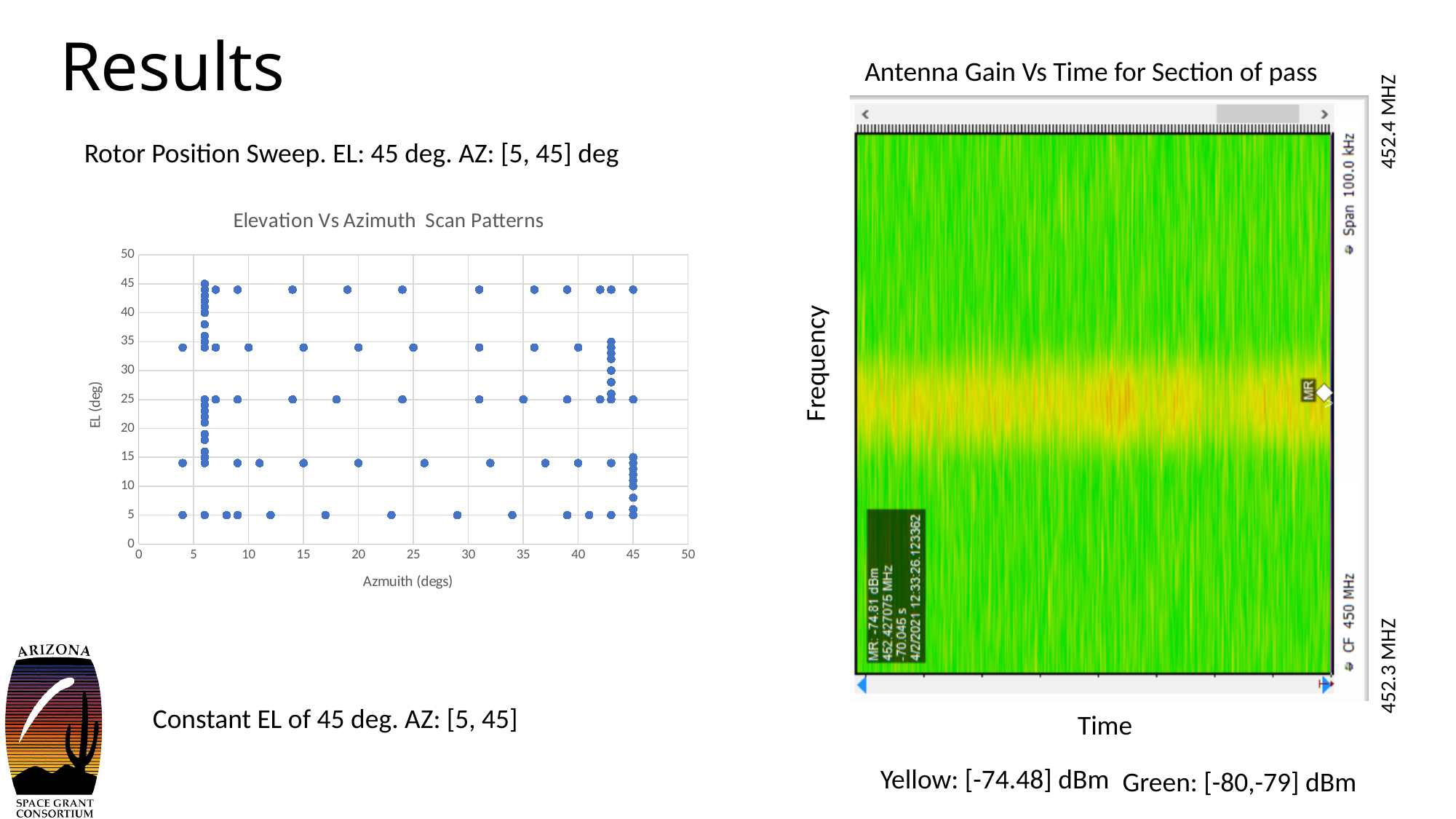
In the 'Elevation Vs Azimuth Scan Patterns' chart, is the lowest plotted EL value greater or less than 10? less In the 'Antenna Gain Vs Time for Section of pass' chart, what frequency is labelled at the bottom of the vertical axis? 452.3 MHZ What is the title of the chart on the left of the slide? Elevation Vs Azimuth Scan Patterns In the 'Elevation Vs Azimuth Scan Patterns' chart, is the highest plotted EL value greater or less than 40? greater In the 'Antenna Gain Vs Time for Section of pass' chart, what power range does the green colour represent according to the slide? [-80,-79] dBm What is the title of the chart on the right of the slide? Antenna Gain Vs Time for Section of pass In the 'Antenna Gain Vs Time for Section of pass' chart, what power level does the yellow colour represent according to the slide? [-74.48] dBm In the 'Elevation Vs Azimuth Scan Patterns' chart, what is the label of the horizontal axis? Azmuith (degs) In the 'Elevation Vs Azimuth Scan Patterns' chart, what is the maximum value shown on the vertical EL (deg) axis? 50 In the 'Antenna Gain Vs Time for Section of pass' chart, what frequency is labelled at the top of the vertical axis? 452.4 MHZ What kind of chart is the 'Elevation Vs Azimuth Scan Patterns' chart? scatter chart In the 'Elevation Vs Azimuth Scan Patterns' chart, is the largest plotted azimuth value greater or less than 40? greater